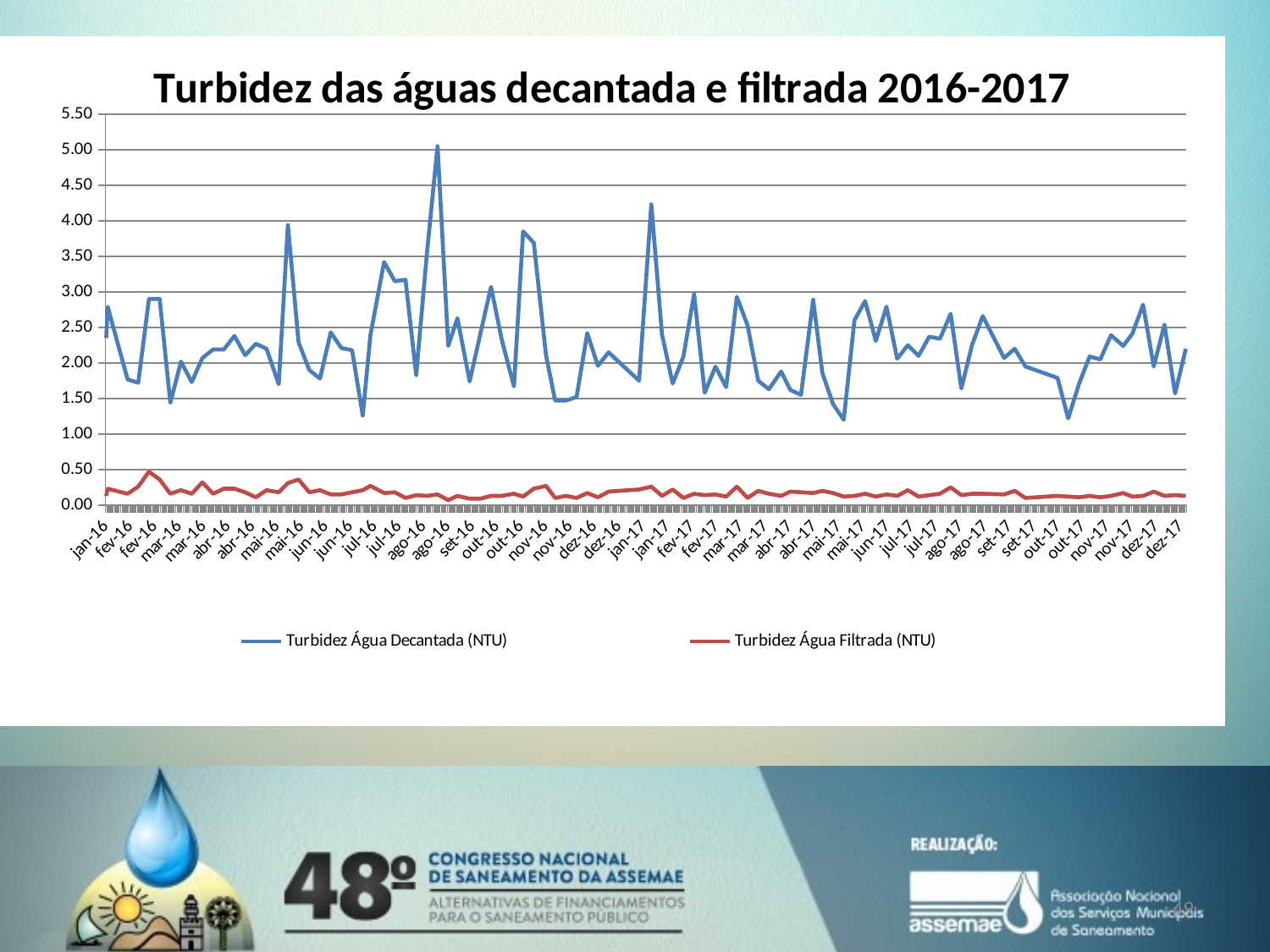
Is the peak of the Turbidez Água Decantada (NTU) series near jan-17 greater or less than 3.50? greater Is the highest value of the Turbidez Água Filtrada (NTU) series greater or less than 1.00? less Is the highest value of the Turbidez Água Decantada (NTU) series greater or less than 4.50? greater What kind of chart is shown on the slide? line chart Which series is drawn in red according to the legend? Turbidez Água Filtrada (NTU) What is the maximum value shown on the vertical axis? 5.50 Which series has higher values throughout the chart, Turbidez Água Decantada (NTU) or Turbidez Água Filtrada (NTU)? Turbidez Água Decantada (NTU) Around which month does the Turbidez Água Decantada (NTU) series reach its highest peak? ago-16 How many series does the legend list? 2 What is the title of the chart? Turbidez das águas decantada e filtrada 2016-2017